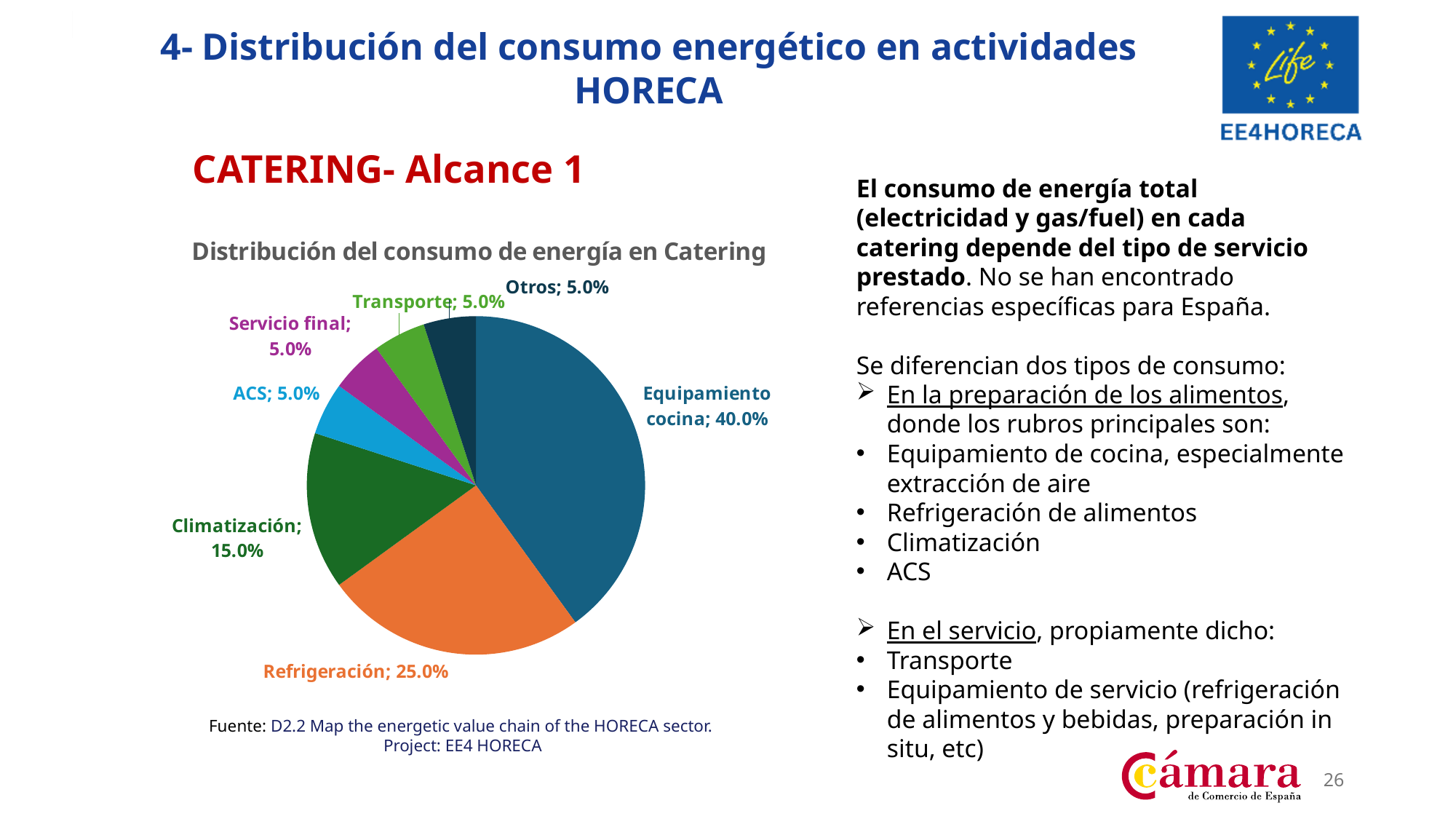
What is the combined share of Transporte, Servicio final and Otros? 15.0% What colour is the Refrigeración slice? Orange What is the value shown for Climatización? 15.0% What is the value shown for ACS? 5.0% What is the title of the chart? Distribución del consumo de energía en Catering What is the difference between the shares of Equipamiento cocina and Refrigeración? 15.0% What type of chart is shown on the slide? Pie chart What share of energy consumption does Equipamiento cocina account for? 40.0% How many slices does the pie chart have? 7 Which is larger, the share for Climatización or the share for Refrigeración? Refrigeración What is the value shown for Refrigeración? 25.0% Which category has the largest slice of the pie? Equipamiento cocina